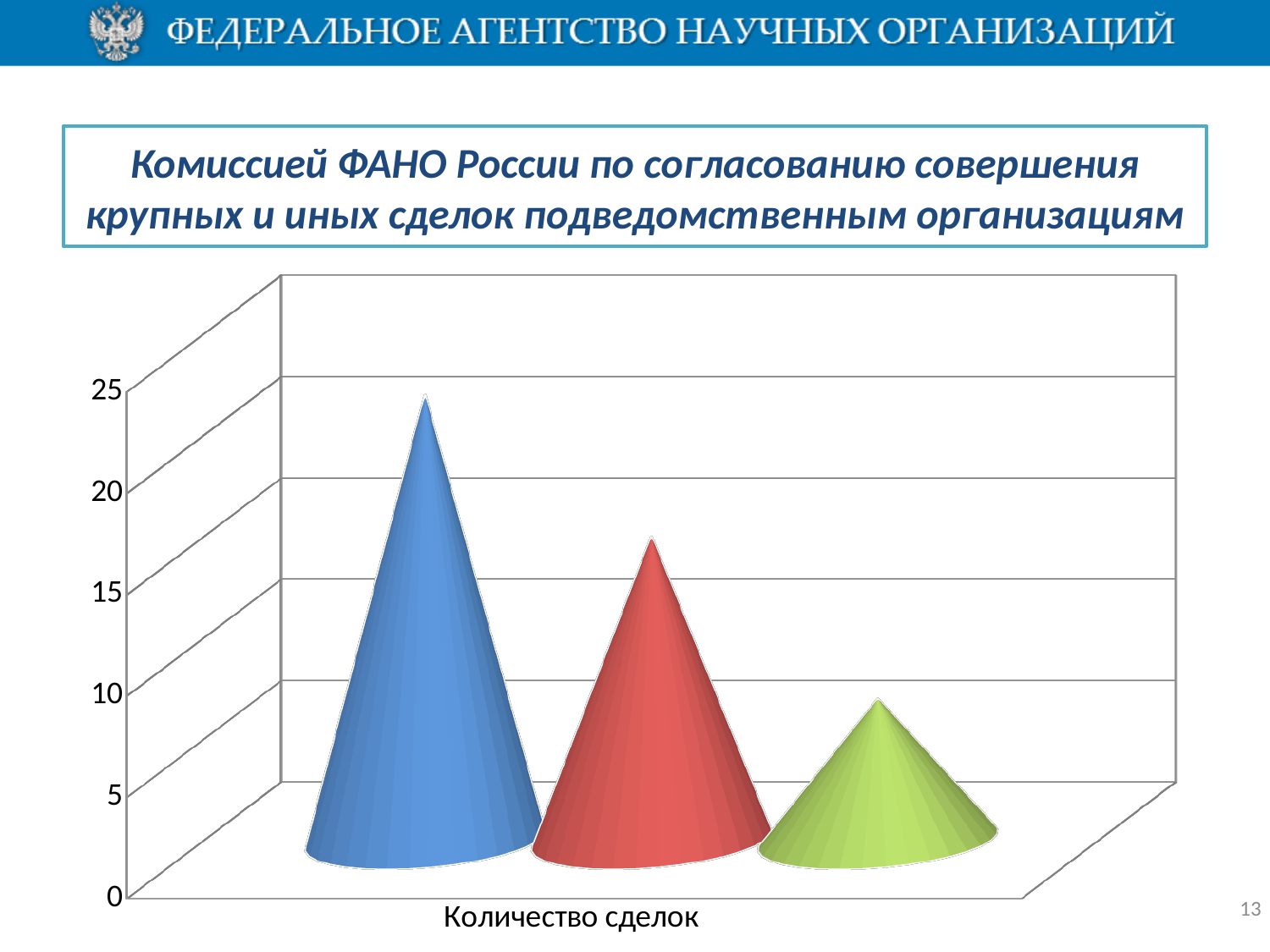
How many categories are shown on the x axis of the chart? 1 What kind of chart is shown on the slide? bar chart Is the value of the blue bar greater or less than 20? greater Is the value of the green bar greater or less than 15? less Which is larger, the red bar or the green bar? red Is the value of the red bar greater or less than 20? less Which coloured bar is the shortest in the chart? green Which coloured bar is the tallest in the chart? blue What is the label of the category on the x axis? Количество сделок Which is larger, the blue bar or the red bar? blue How many bars (cones) are plotted in the chart? 3